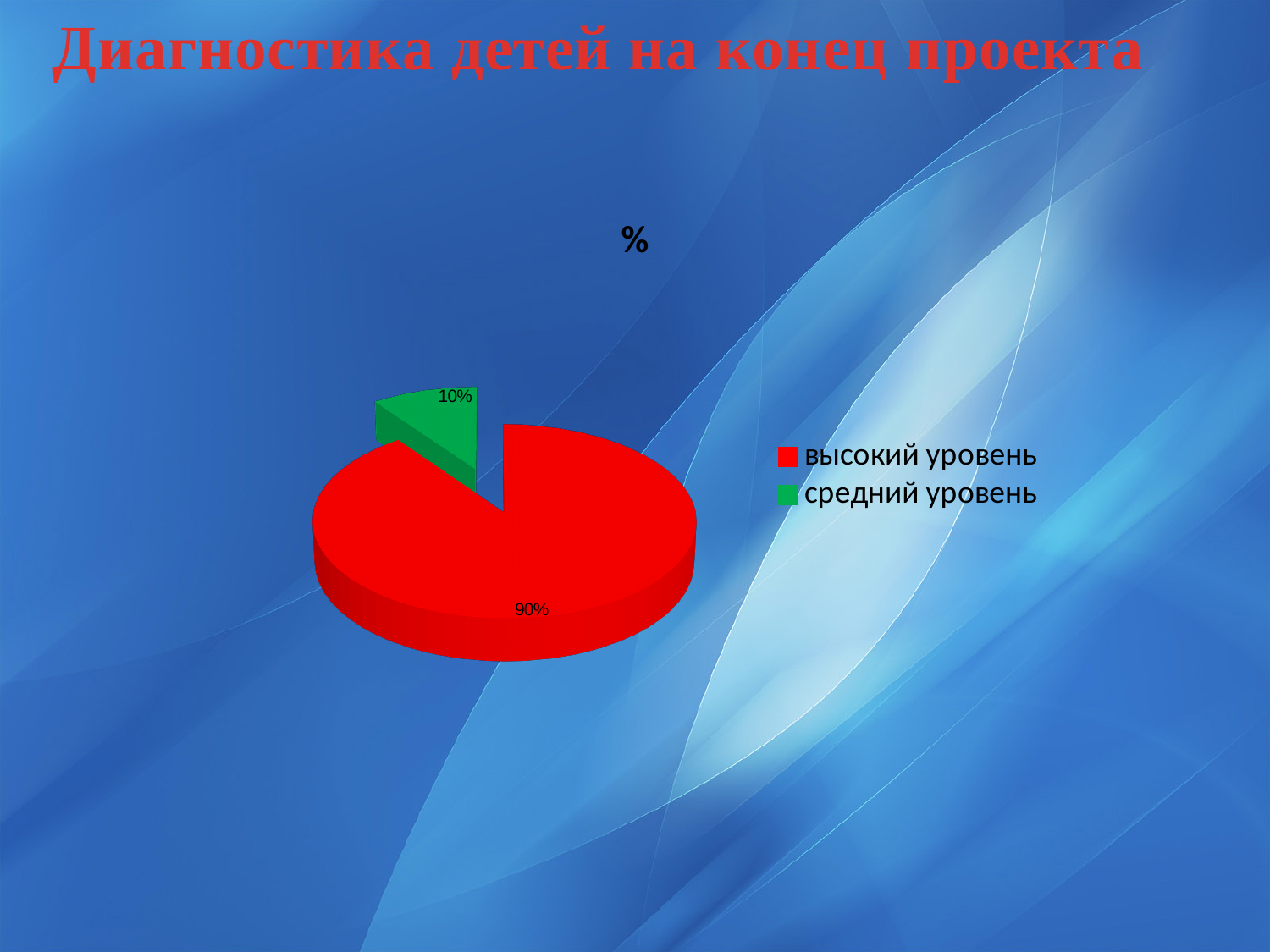
What is the value for высокий уровень? 90% How many entries does the legend list? 2 Which is larger, the slice for высокий уровень or the slice for средний уровень? высокий уровень What is the difference between the values for высокий уровень and средний уровень? 80% What is the value for средний уровень? 10% Which category has the smallest slice? средний уровень What is the title of the chart? % How many slices does the pie chart have? 2 What kind of chart is shown on the slide? pie chart What colour is the slice for средний уровень? green What share of the pie does средний уровень take? 10% Which category has the largest slice? высокий уровень